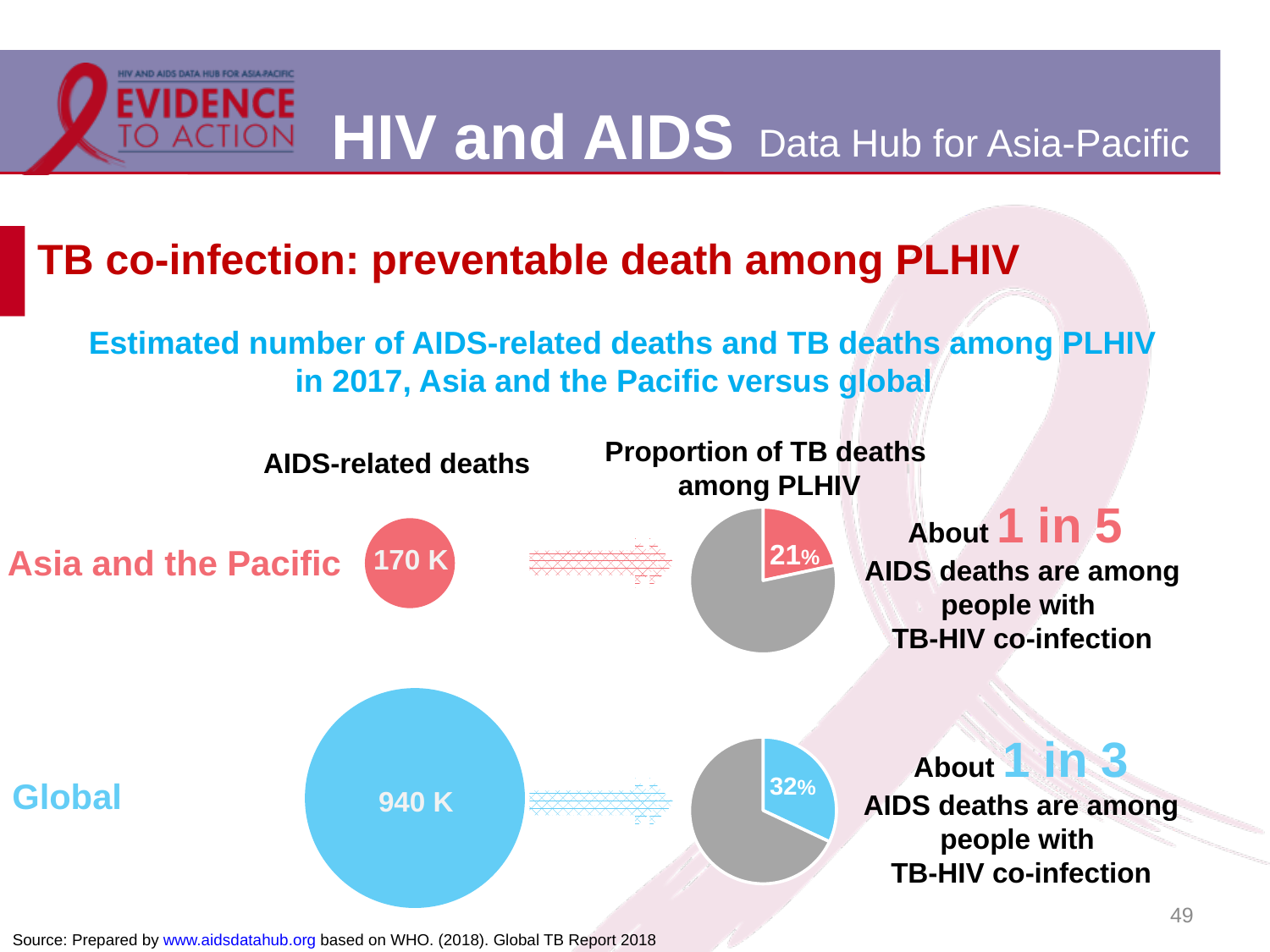
What share of the Asia and the Pacific pie chart is taken by the highlighted (pink) slice? 21% What is the estimated number of AIDS-related deaths in Asia and the Pacific in 2017? 170 K According to the slide, about how many AIDS deaths globally are among people with TB-HIV co-infection? About 1 in 3 Which has the higher proportion of TB deaths among PLHIV, Asia and the Pacific or Global? Global What is the estimated number of AIDS-related deaths globally in 2017? 940 K What kind of chart is used to show the proportion of TB deaths among PLHIV? Pie chart Which region has the larger number of AIDS-related deaths, Asia and the Pacific or Global? Global In the pie chart for Global, what proportion of AIDS-related deaths are TB deaths among PLHIV? 32% In the pie chart for Asia and the Pacific, what proportion of AIDS-related deaths are TB deaths among PLHIV? 21% What is the difference in percentage points between the global proportion of TB deaths among PLHIV and the Asia and the Pacific proportion? 11 percentage points How many regions are compared on the slide? 2 According to the slide, about how many AIDS deaths in Asia and the Pacific are among people with TB-HIV co-infection? About 1 in 5